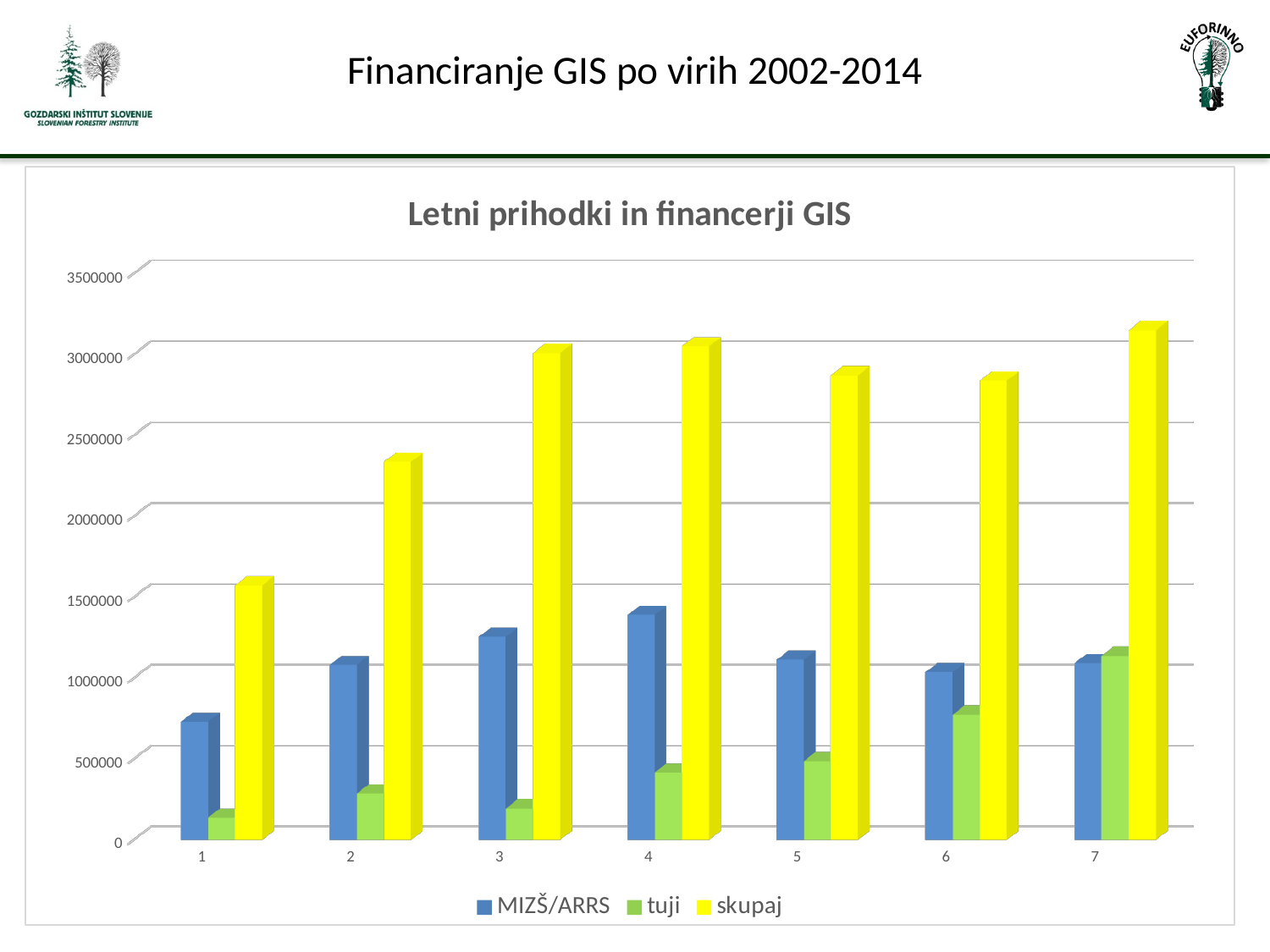
For which category is the 'MIZŠ/ARRS' value highest? 4 For which category is the 'tuji' value lowest? 1 Which colour represents the series 'skupaj' in the chart? yellow Which is larger for category 6: the 'MIZŠ/ARRS' value or the 'tuji' value? MIZŠ/ARRS Is the 'skupaj' value for category 3 greater or less than 2500000? greater How many categories are shown along the x axis of the chart? 7 What kind of chart is shown on the slide? bar chart How many series does the chart legend list? 3 Is the 'MIZŠ/ARRS' value for category 1 greater or less than 1000000? less For which category is the 'tuji' value highest? 7 For which category is the 'skupaj' value lowest? 1 What is the title of the chart? Letni prihodki in financerji GIS